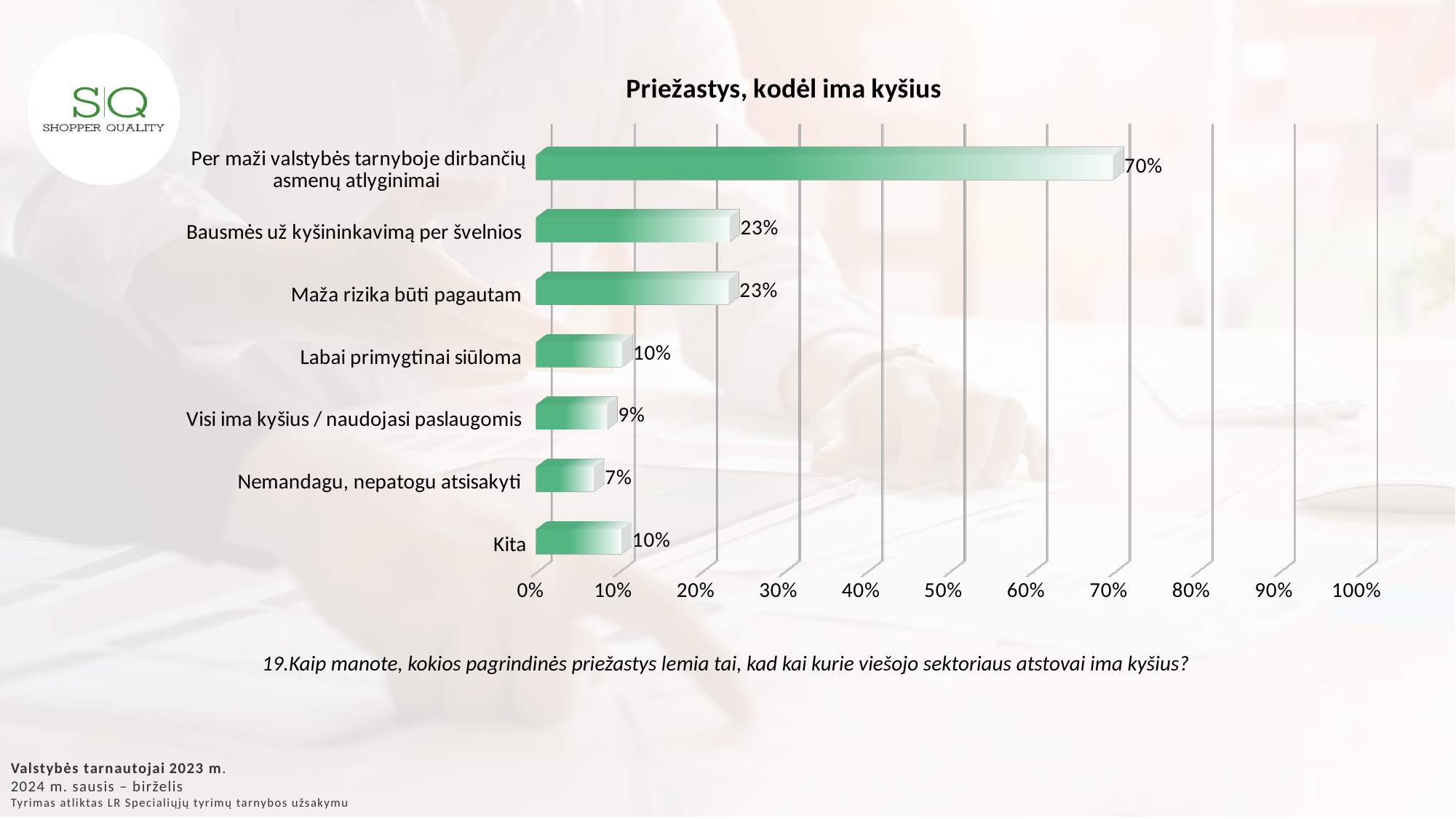
Is the value for "Maža rizika būti pagautam" greater or less than 20%? greater Which category has the lowest value? Nemandagu, nepatogu atsisakyti Which category has the highest value? Per maži valstybės tarnyboje dirbančių asmenų atlyginimai What is the value for "Per maži valstybės tarnyboje dirbančių asmenų atlyginimai"? 70% What is the value for "Kita"? 10% What is the value for "Nemandagu, nepatogu atsisakyti"? 7% What is the difference between the values for "Per maži valstybės tarnyboje dirbančių asmenų atlyginimai" and "Bausmės už kyšininkavimą per švelnios"? 47% How many categories are shown in the chart? 7 What is the value for "Visi ima kyšius / naudojasi paslaugomis"? 9% What is the title of the chart? Priežastys, kodėl ima kyšius Which is larger: the value for "Labai primygtinai siūloma" or the value for "Nemandagu, nepatogu atsisakyti"? Labai primygtinai siūloma What kind of chart is shown on the slide? bar chart